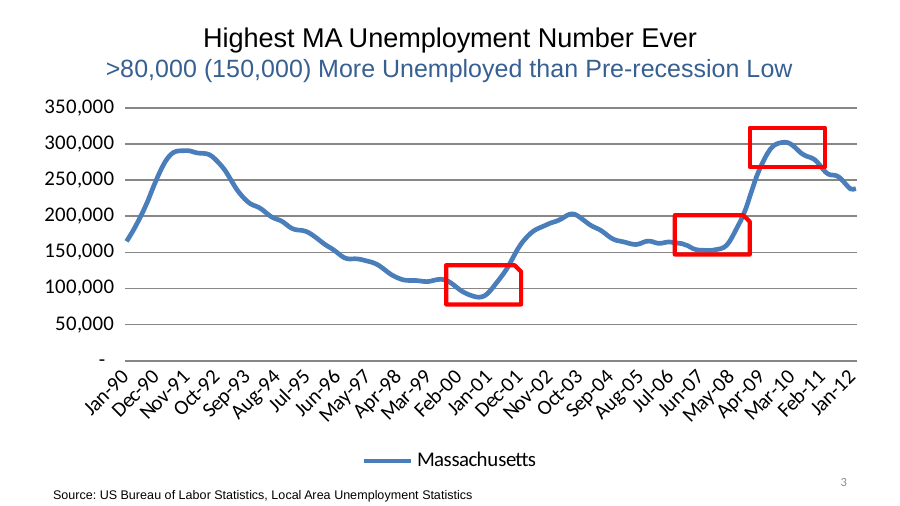
What is the name of the series shown in the legend? Massachusetts Is the value for Mar-10 greater or less than 250,000? greater Is the value for Nov-91 greater or less than 250,000? greater Do the values rise or fall between Jan-90 and Nov-91? rise What kind of chart is shown on the slide? Line chart Which labeled month on the x axis has the lowest value? Jan-01 Do the values rise or fall between Nov-91 and Jan-01? fall Is the value for Jan-12 greater or less than 250,000? less How many series does the legend list? 1 What is the title of the chart? Highest MA Unemployment Number Ever